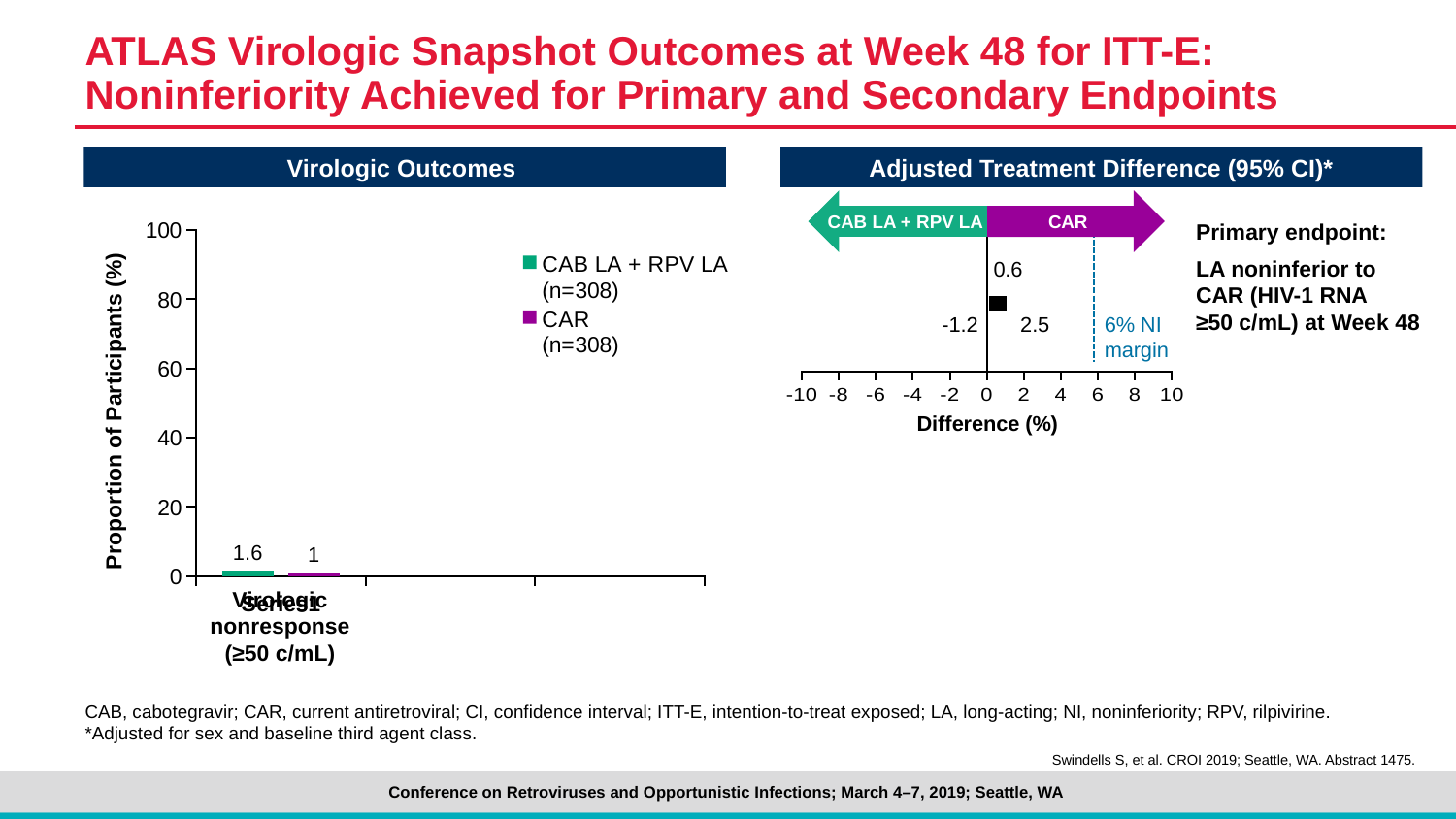
In the Adjusted Treatment Difference (95% CI) chart, what is the point estimate of the adjusted treatment difference? 0.6 In the Virologic Outcomes chart, what is the value for CAR for virologic nonresponse (≥50 c/mL)? 1 In the Adjusted Treatment Difference (95% CI) chart, what noninferiority margin is marked by the dashed line? 6% NI margin In the Virologic Outcomes chart, what is the value for CAB LA + RPV LA for virologic nonresponse (≥50 c/mL)? 1.6 In the Virologic Outcomes chart, which series has the higher virologic nonresponse value, CAB LA + RPV LA or CAR? CAB LA + RPV LA In the Adjusted Treatment Difference (95% CI) chart, what is the upper bound of the 95% confidence interval? 2.5 In the Virologic Outcomes chart, is the value for CAB LA + RPV LA greater or less than 20? less In the Adjusted Treatment Difference (95% CI) chart, what is the lower bound of the 95% confidence interval? -1.2 How many series does the legend of the Virologic Outcomes chart list? 2 In the Virologic Outcomes chart, what is the difference between the CAB LA + RPV LA and CAR virologic nonresponse values? 0.6 What kind of chart is the Virologic Outcomes chart? Bar chart What is the y-axis label of the Virologic Outcomes chart? Proportion of Participants (%)